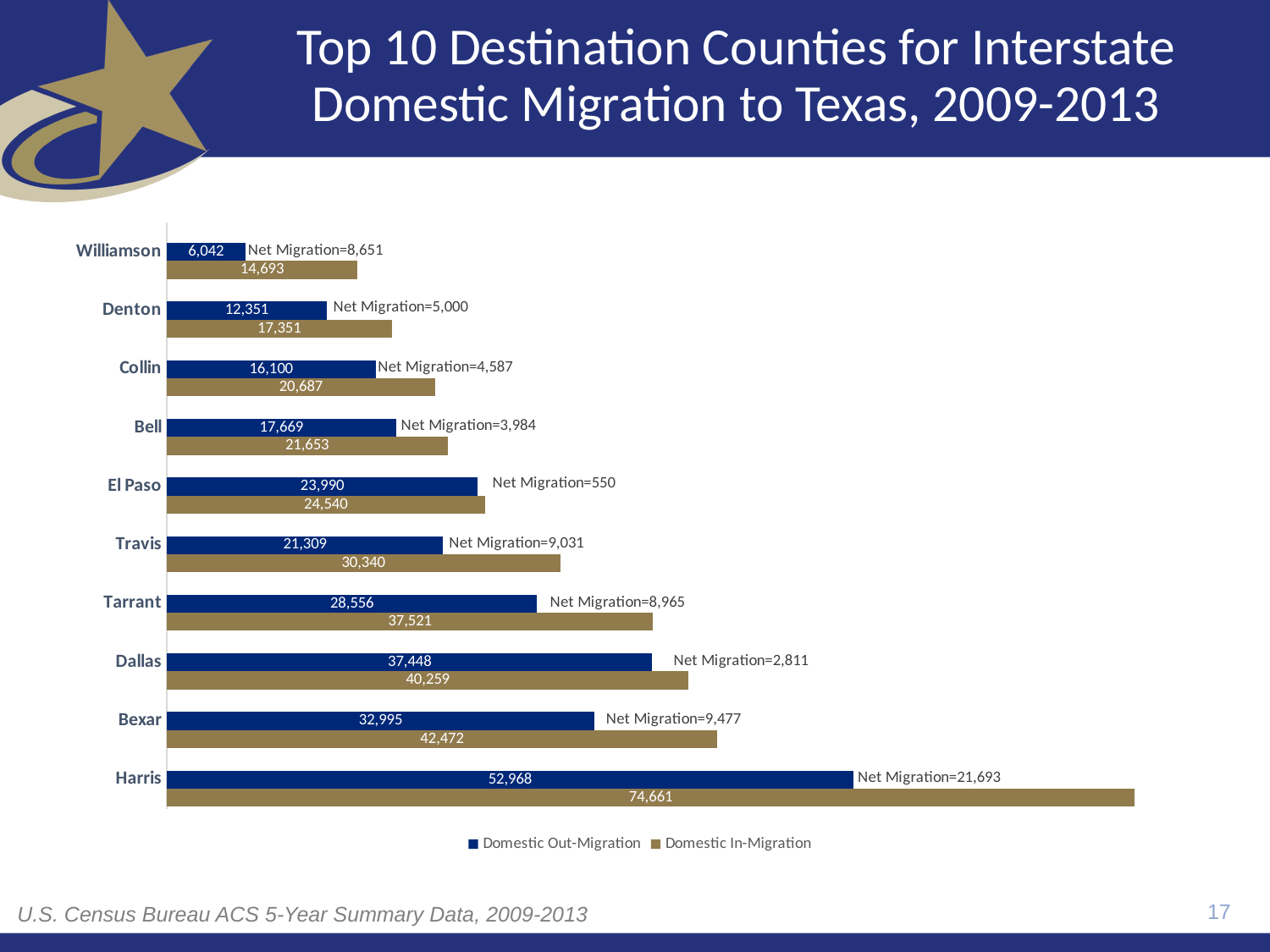
What is the difference between Domestic In-Migration and Domestic Out-Migration for Tarrant County? 8,965 What is the Domestic In-Migration value for Travis County? 30,340 Which county has the lowest Domestic Out-Migration value? Williamson How many counties are shown in the chart? 10 What is the difference between Domestic In-Migration and Domestic Out-Migration for Dallas County? 2,811 Which county has the larger Domestic Out-Migration value, Dallas or Bexar? Dallas How many series does the legend list? 2 What net migration figure is shown for El Paso County? 550 What is the Domestic Out-Migration value for Bexar County? 32,995 What kind of chart is shown on the slide? Bar chart Which county has the highest Domestic In-Migration value? Harris What is the Domestic In-Migration value for Harris County? 74,661